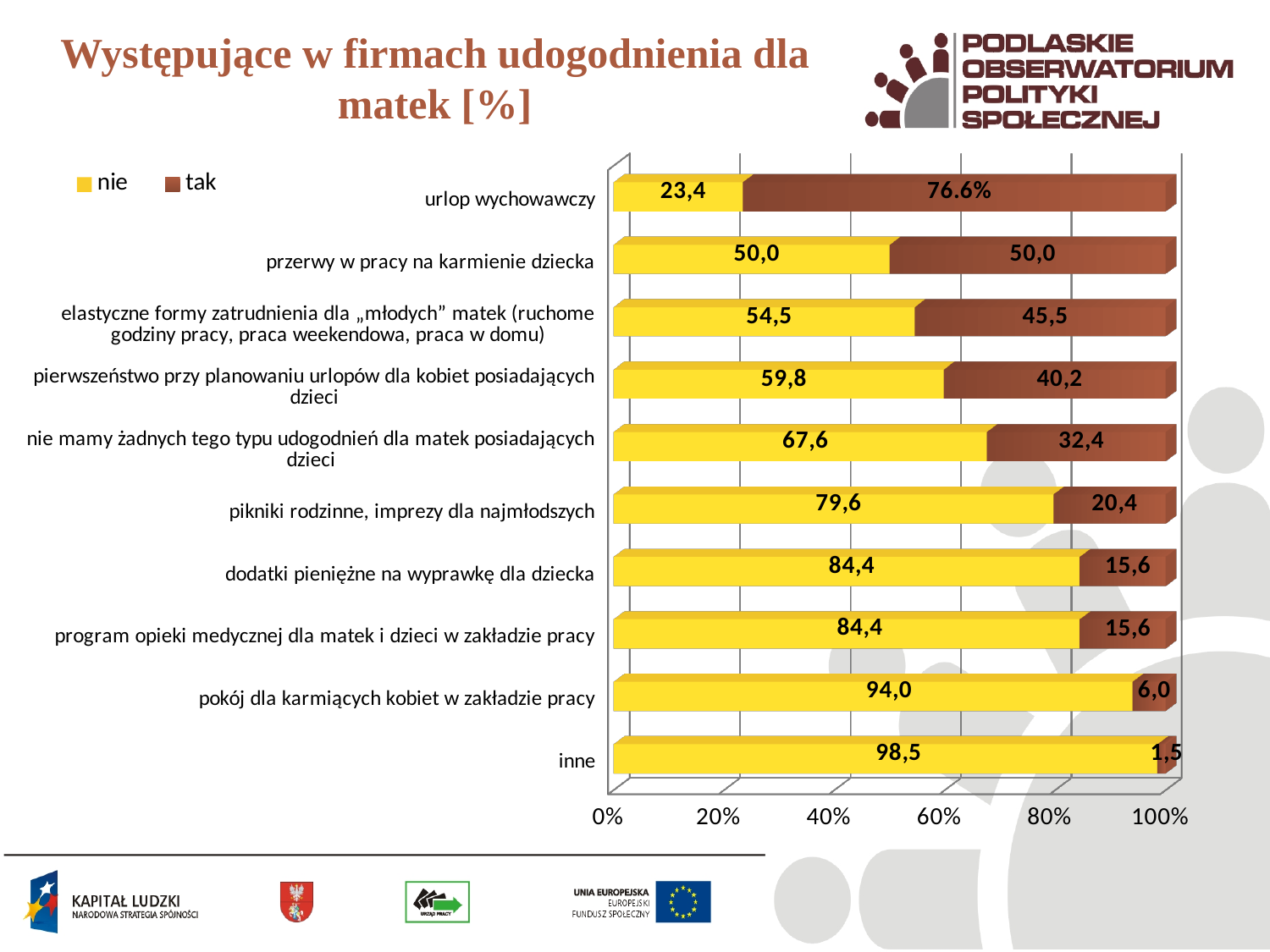
Which category has the highest "tak" value? urlop wychowawczy What is the "tak" value for "pikniki rodzinne, imprezy dla najmłodszych"? 20,4 Which is larger for "elastyczne formy zatrudnienia dla „młodych” matek": the "nie" value or the "tak" value? nie What is the "tak" value for "urlop wychowawczy"? 76.6% What is the "nie" value for "przerwy w pracy na karmienie dziecka"? 50,0 How many categories are shown on the chart? 10 Which colour represents the "tak" series in the chart? brown What is the "nie" value for "pokój dla karmiących kobiet w zakładzie pracy"? 94,0 How many series does the legend list? 2 What is the difference between the "nie" and "tak" values for "pierwszeństwo przy planowaniu urlopów dla kobiet posiadających dzieci"? 19,6 Which category has the lowest "tak" value? inne What kind of chart is shown on the slide? stacked bar chart